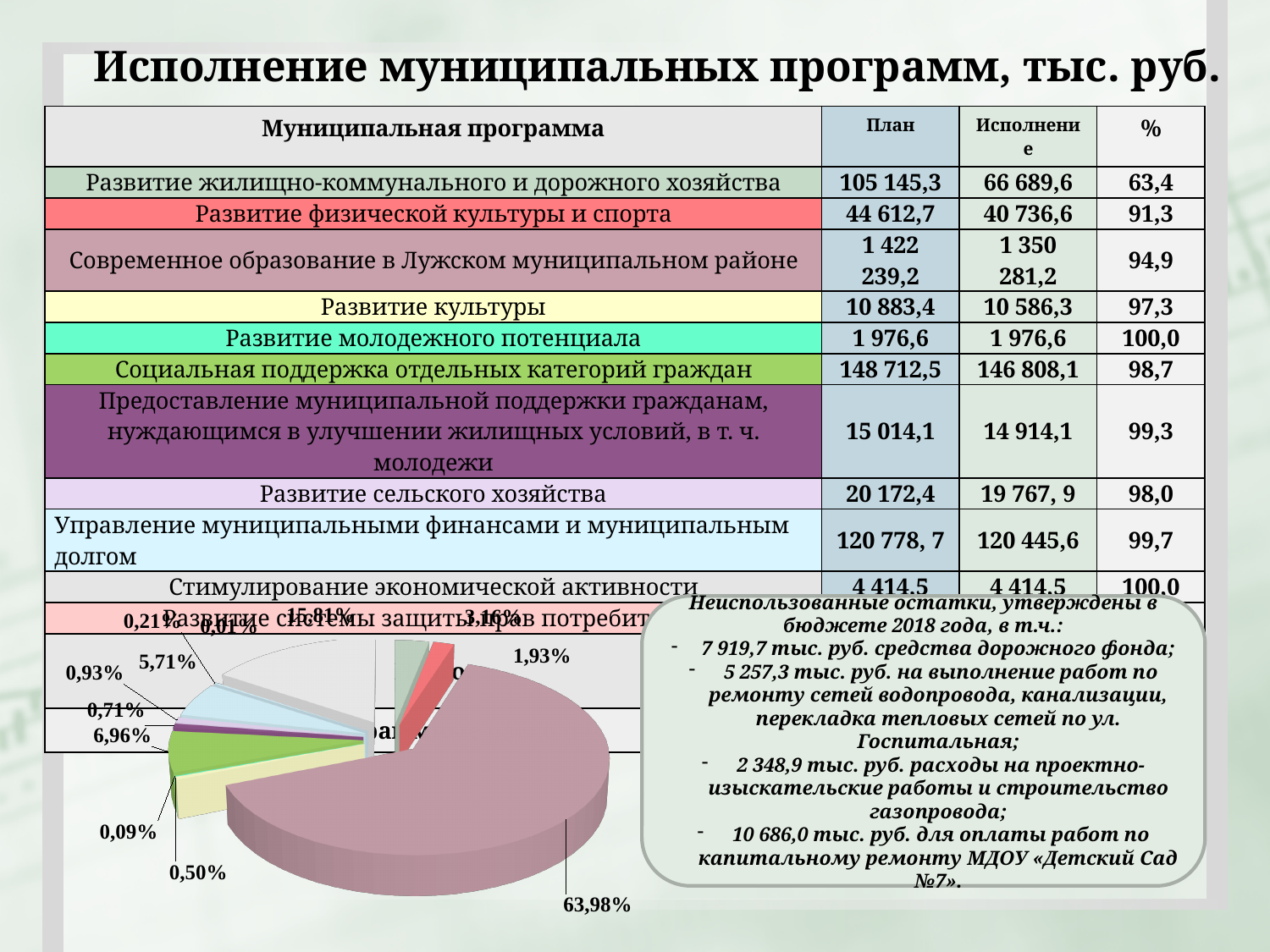
What kind of chart is shown at the bottom left of the slide? pie chart In the pie chart, which is larger: the slice labelled 15,81% or the slice labelled 6,96%? 15,81% What is the difference between the slice labelled 63,98% and the slice labelled 15,81% in the pie chart? 48,17% Is the slice labelled 5,71% in the pie chart greater or less than 10%? less Is the pie chart drawn with a 3D effect? yes What share of the pie does the largest slice take? 63,98% Does the pie chart display a legend? no Is the largest slice of the pie chart greater or less than 50%? greater What is the smallest percentage label shown on the pie chart? 0,01% What is the percentage of the largest slice in the pie chart? 63,98%